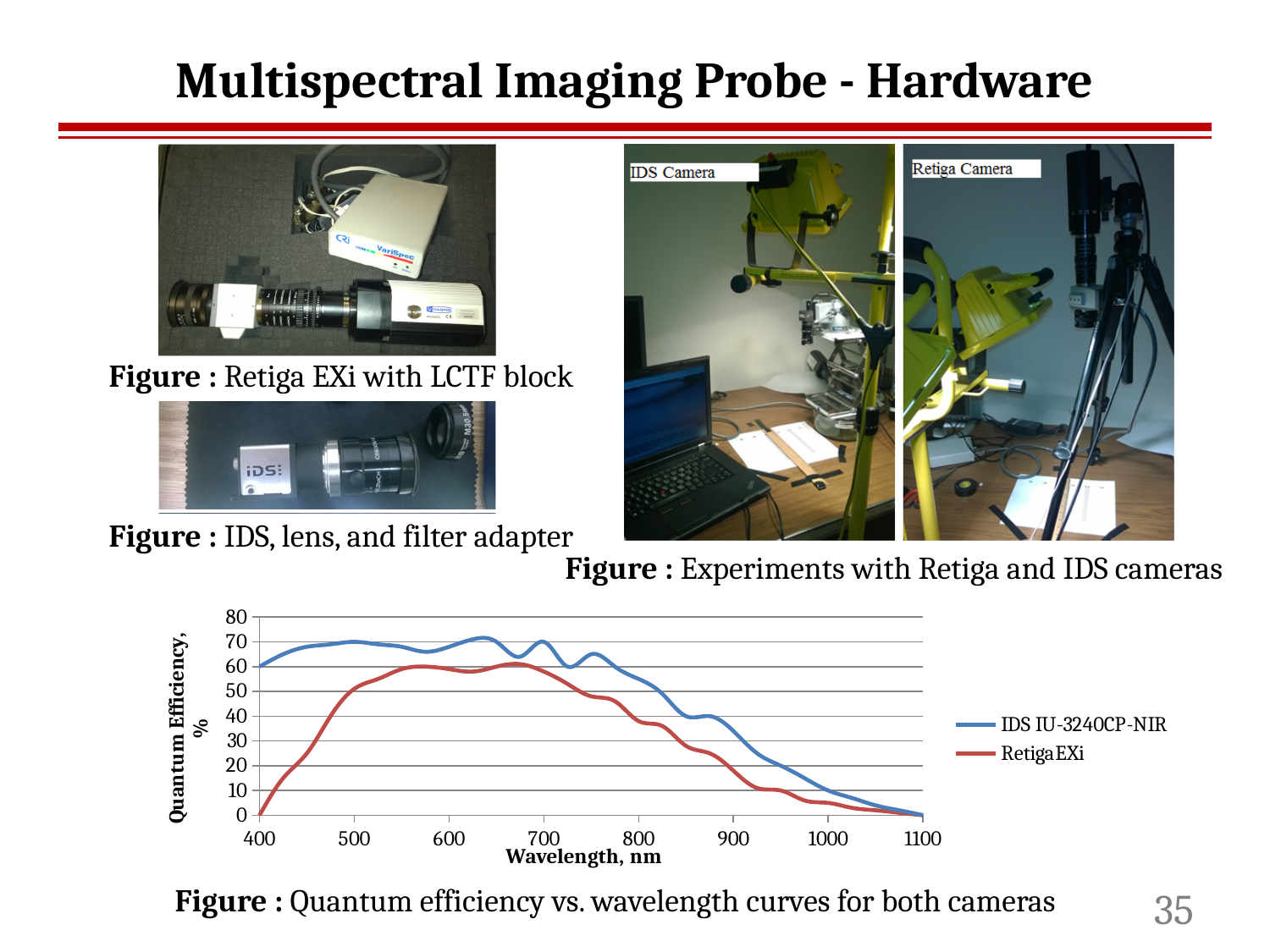
In the quantum efficiency chart, is the value for Retiga EXi at 800 nm greater or less than 30? greater In the quantum efficiency chart, is the value for IDS IU-3240CP-NIR at 900 nm greater or less than 40? less In the quantum efficiency chart, which series has the higher value at 800 nm, IDS IU-3240CP-NIR or Retiga EXi? IDS IU-3240CP-NIR What are the two series named in the legend of the quantum efficiency chart? IDS IU-3240CP-NIR and Retiga EXi In the quantum efficiency chart, does the IDS IU-3240CP-NIR curve rise or fall between 700 nm and 1100 nm? fall In the quantum efficiency chart, is the value for Retiga EXi at 600 nm greater or less than 50? greater What kind of chart is shown at the bottom of the slide? line chart What is the x-axis label of the quantum efficiency chart? Wavelength, nm How many series does the legend of the quantum efficiency chart list? 2 In the quantum efficiency chart, which series reaches the higher peak quantum efficiency? IDS IU-3240CP-NIR